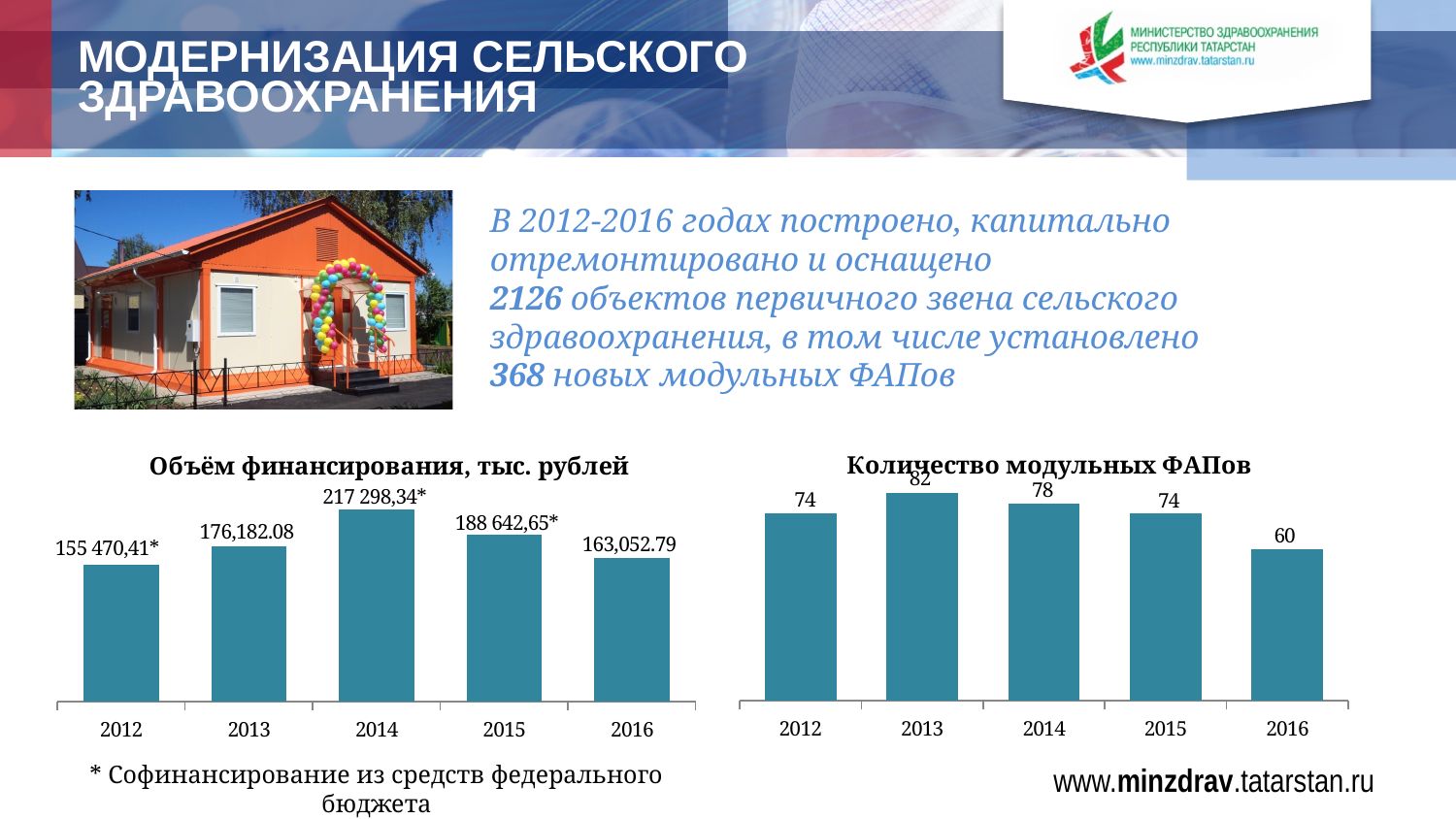
In the chart 'Объём финансирования, тыс. рублей', which year has the highest value? 2014 In the chart 'Объём финансирования, тыс. рублей', what is the value for 2016? 163,052.79 In the chart 'Количество модульных ФАПов', do the values rise or fall from 2014 to 2016? fall In the chart 'Объём финансирования, тыс. рублей', which year has the lowest value? 2012 In the chart 'Количество модульных ФАПов', which year has the lowest value? 2016 In the chart 'Количество модульных ФАПов', what is the value for 2013? 82 In the chart 'Объём финансирования, тыс. рублей', what is the value for 2014? 217 298,34* In the chart 'Количество модульных ФАПов', what is the difference between the values for 2014 and 2015? 4 How many years are shown in the chart 'Объём финансирования, тыс. рублей'? 5 In the chart 'Объём финансирования, тыс. рублей', is the value for 2013 larger or smaller than the value for 2015? smaller In the chart 'Количество модульных ФАПов', what is the difference between the values for 2013 and 2016? 22 What type of chart is 'Количество модульных ФАПов'? bar chart